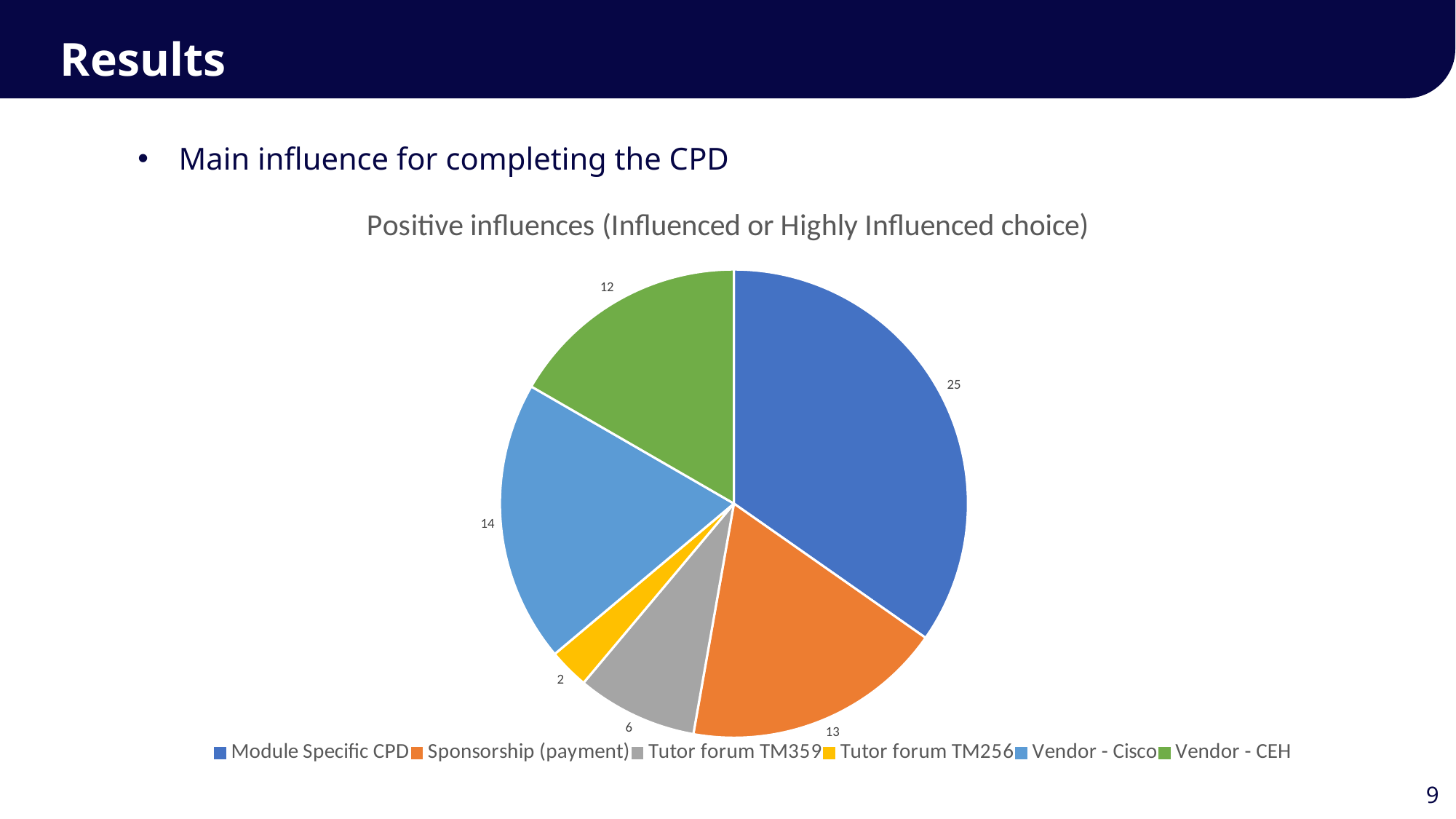
What type of chart is shown on the slide? pie chart What is the value for Tutor forum TM256? 2 What is the value for Sponsorship (payment)? 13 What is the total of all slices in the pie chart? 72 What is the value for Module Specific CPD? 25 Which is larger, Vendor - Cisco or Vendor - CEH? Vendor - Cisco What is the difference between the values for Module Specific CPD and Sponsorship (payment)? 12 Which category has the smallest slice? Tutor forum TM256 Which category has the largest slice? Module Specific CPD What is the title of the chart? Positive influences (Influenced or Highly Influenced choice) What is the value for Vendor - Cisco? 14 How many categories does the pie chart have? 6